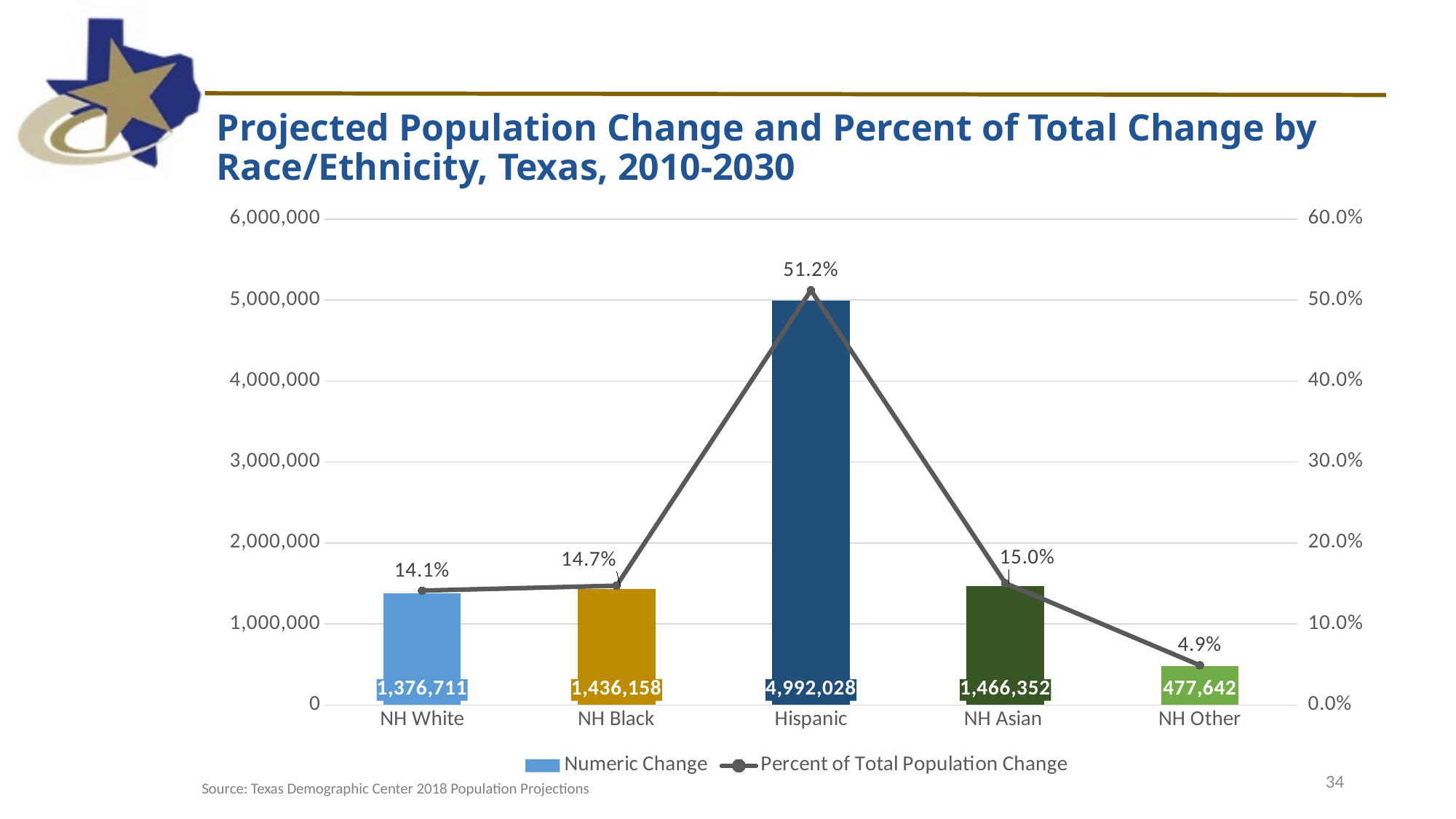
What is the difference in Numeric Change between NH Black and NH White? 59,447 What is the Numeric Change value for NH Other? 477,642 Is the Numeric Change for Hispanic greater or less than 4,000,000? greater What is the Percent of Total Population Change for NH Asian? 15.0% Which race/ethnicity group has the highest Numeric Change? Hispanic How many race/ethnicity categories are shown on the x axis? 5 What is the difference in Numeric Change between Hispanic and NH Asian? 3,525,676 Which has a larger Numeric Change, NH White or NH Other? NH White What is the Numeric Change value for Hispanic? 4,992,028 How many series does the legend list? 2 What kind of chart is shown on the slide? A bar chart combined with a line chart Which race/ethnicity group has the lowest Percent of Total Population Change? NH Other